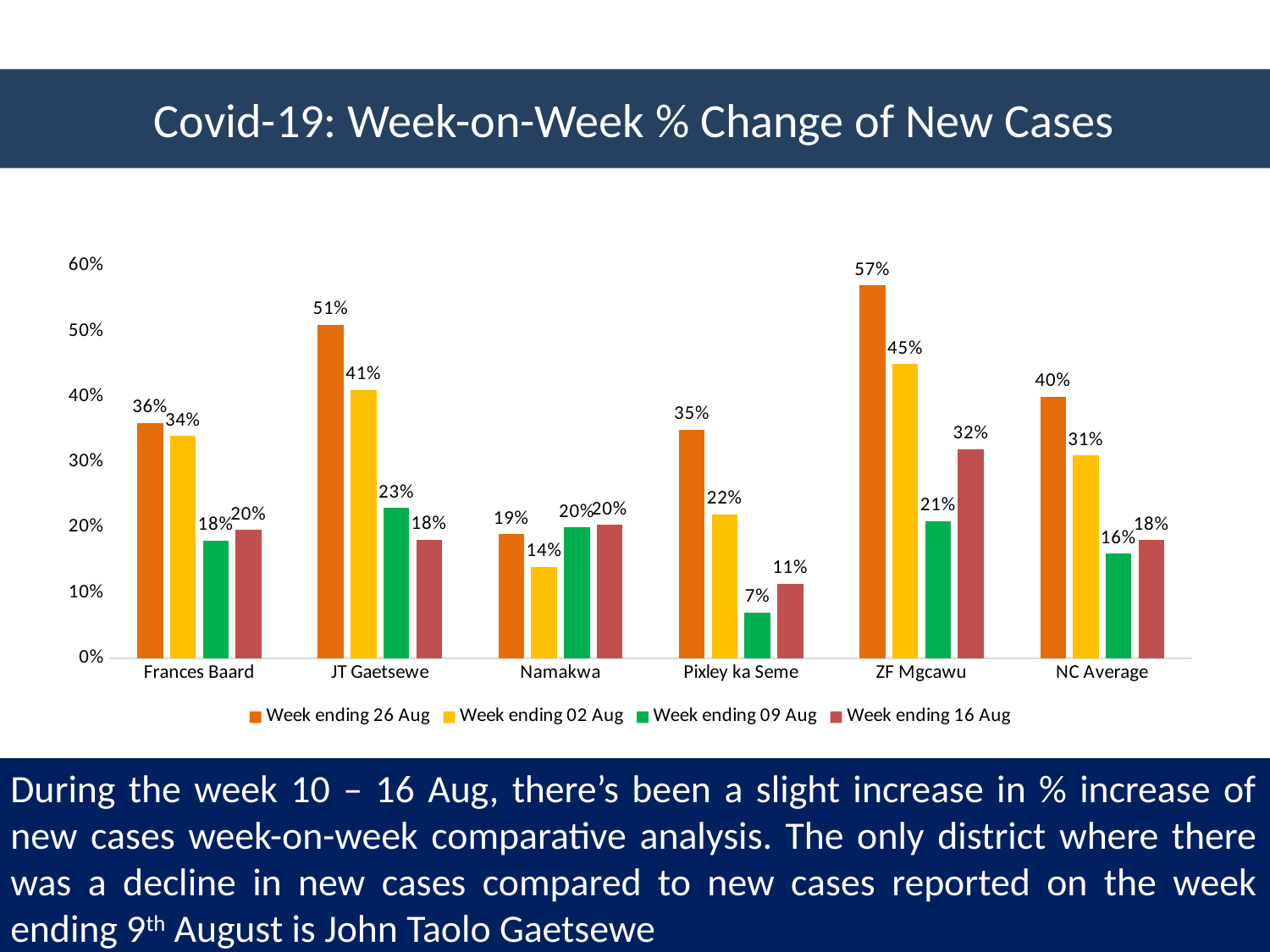
What is the title of the chart? Covid-19: Week-on-Week % Change of New Cases Which is larger for Frances Baard: the Week ending 09 Aug value or the Week ending 16 Aug value? Week ending 16 Aug What is the value for ZF Mgcawu in the Week ending 26 Aug series? 57% What is the value for Namakwa in the Week ending 02 Aug series? 14% What is the value for Pixley ka Seme in the Week ending 09 Aug series? 7% Which category has the lowest value in the Week ending 26 Aug series? Namakwa What kind of chart is shown on the slide? Bar chart Which district has the highest value in the Week ending 16 Aug series? ZF Mgcawu What is the NC Average value for the Week ending 16 Aug series? 18% What is the difference between the Week ending 26 Aug and Week ending 02 Aug values for JT Gaetsewe? 10% How many series does the legend list? 4 How many categories are shown on the x axis? 6